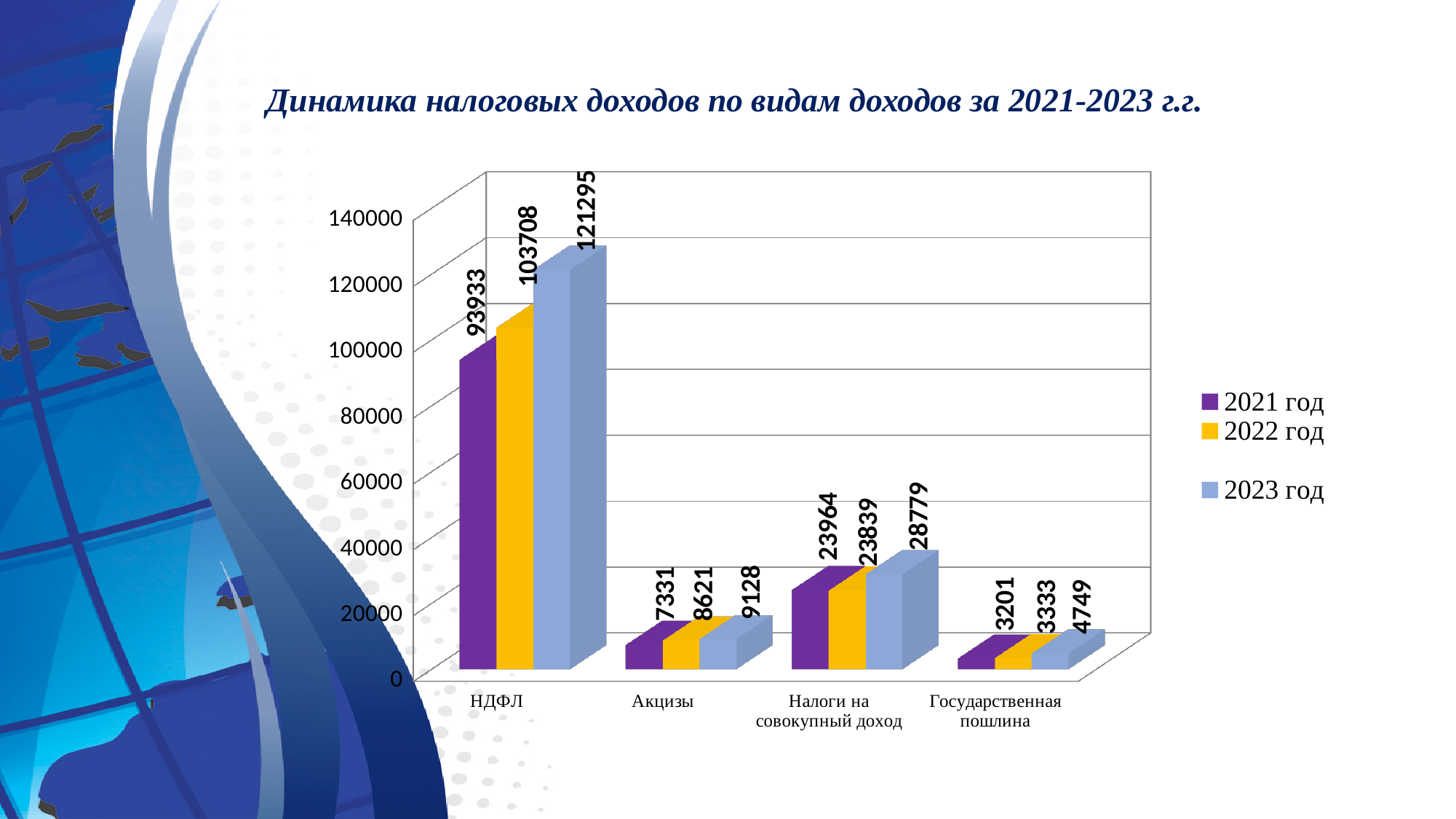
What is the difference between the 2023 год and 2021 год values for НДФЛ? 27362 Which is larger for Налоги на совокупный доход: the 2021 год value or the 2022 год value? 2021 год Do the values for Акцизы rise or fall from 2021 год to 2023 год? Rise What is the value for Государственная пошлина in 2022 год? 3333 How many series does the legend list? 3 Which category has the lowest value in 2023 год? Государственная пошлина What kind of chart is shown on the slide? Bar chart Which category has the highest value in 2021 год? НДФЛ What is the value for Налоги на совокупный доход in 2023 год? 28779 How many categories are shown on the x axis? 4 What is the value for НДФЛ in 2023 год? 121295 What is the value for Акцизы in 2021 год? 7331